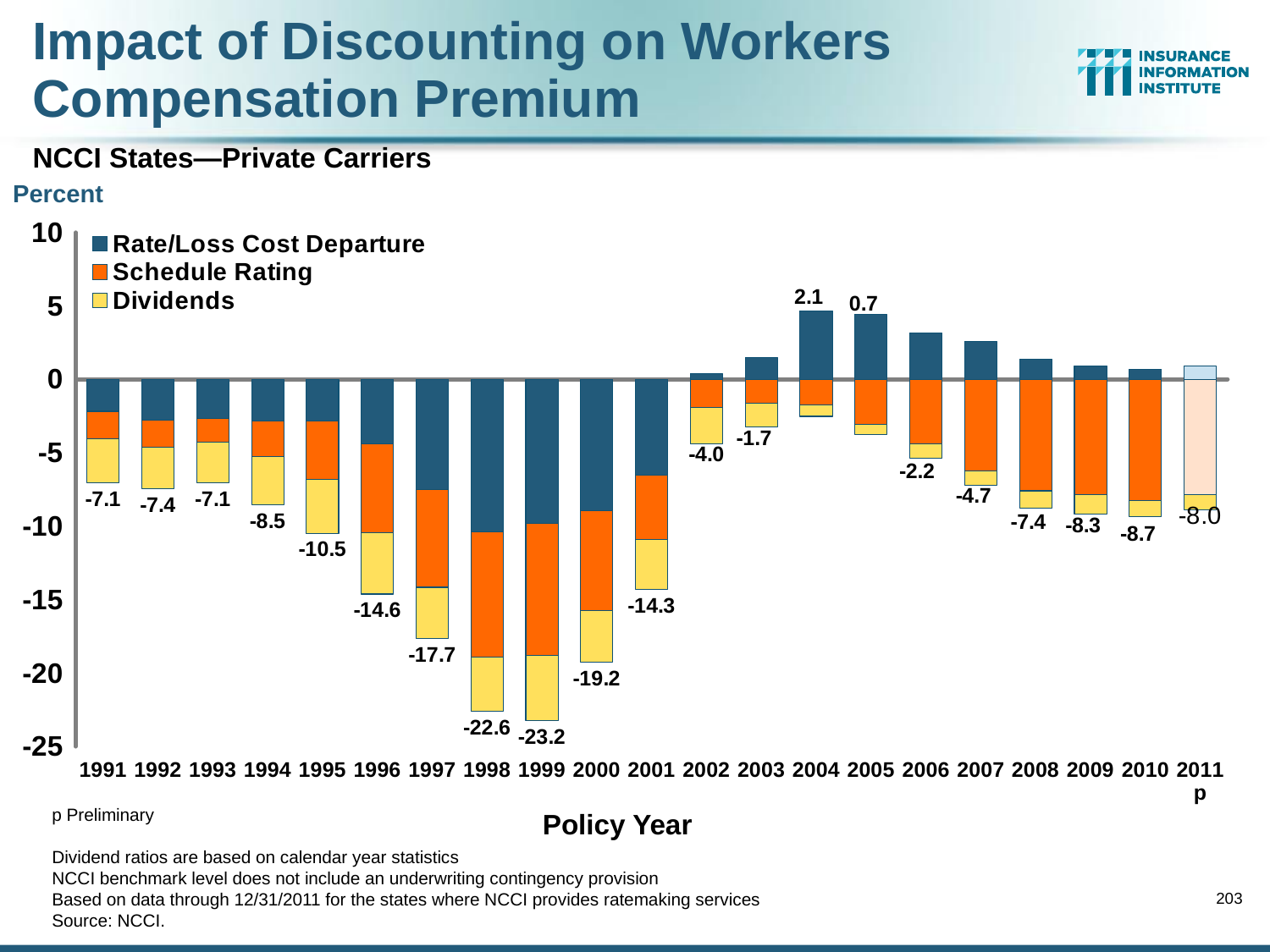
Which policy year has the lowest labeled value? 1999 Do the labeled values rise or fall from 1991 to 1999? Fall What is the difference between the labeled values for 1998 and 1999? 0.6 How many policy years are shown on the x axis? 21 Which series is shown in yellow in the legend? Dividends How many series does the legend list? 3 Which policy year has the highest labeled value? 2004 What is the labeled value for policy year 2011p? -8.0 What kind of chart is shown on the slide? Stacked bar chart What is the labeled value for policy year 2004? 2.1 Which is larger, the labeled value for 2004 or for 2005? 2004 What is the labeled value for policy year 1999? -23.2